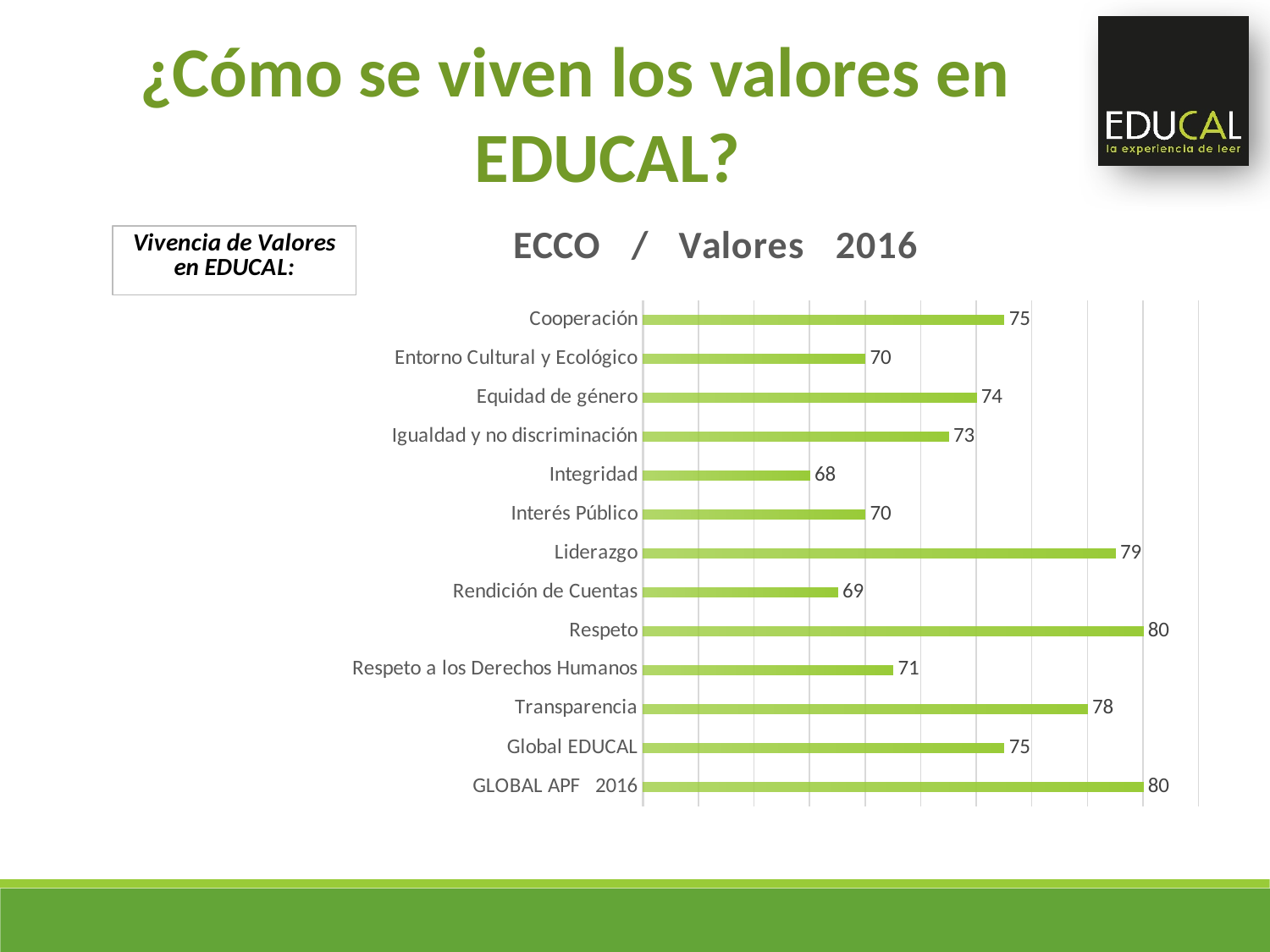
How many categories are shown in the chart? 13 What is the value for Global EDUCAL? 75 What type of chart is shown on the slide? Bar chart What is the value for Respeto a los Derechos Humanos? 71 What is the difference between the values for Liderazgo and Integridad? 11 Which has a higher value, Equidad de género or Rendición de Cuentas? Equidad de género What is the value for Liderazgo in the ECCO / Valores 2016 chart? 79 What is the value for Integridad? 68 What is the difference between the values for GLOBAL APF 2016 and Global EDUCAL? 5 Which category has the lowest value in the chart? Integridad What value is shown for Transparencia? 78 Which has a higher value, Transparencia or Igualdad y no discriminación? Transparencia